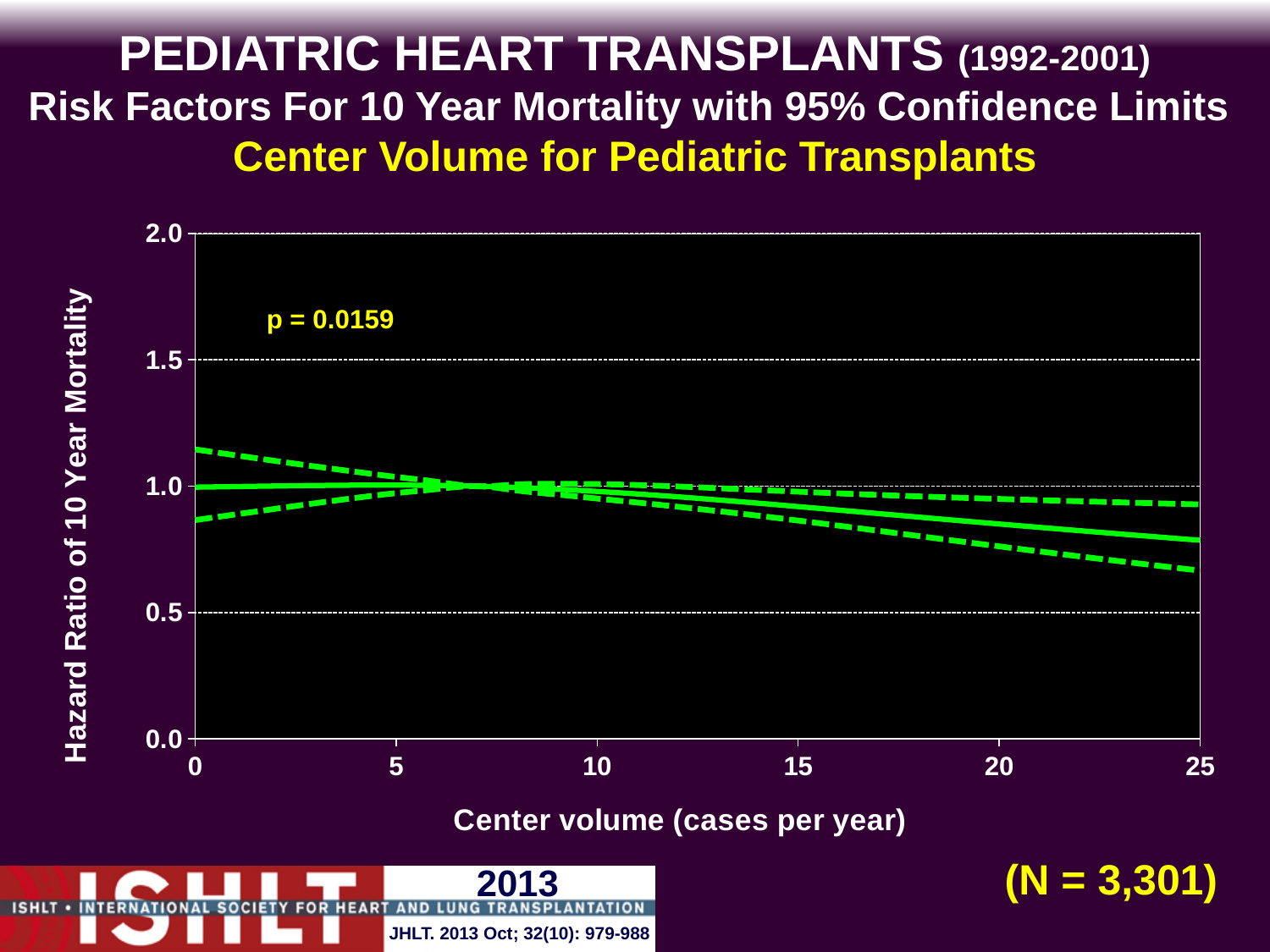
Is the upper dashed confidence limit at a center volume of 0 greater or less than 1.0? greater Does the solid hazard ratio line rise or fall as center volume increases from 0 to 25 cases per year? fall What is the label of the x axis? Center volume (cases per year) What kind of chart is shown on the slide? line chart Is the upper dashed confidence limit at a center volume of 25 cases per year greater or less than 1.0? less Is the lower dashed confidence limit at a center volume of 0 greater or less than 1.0? less How many lines are plotted on the chart? 3 What p-value is printed on the chart? p = 0.0159